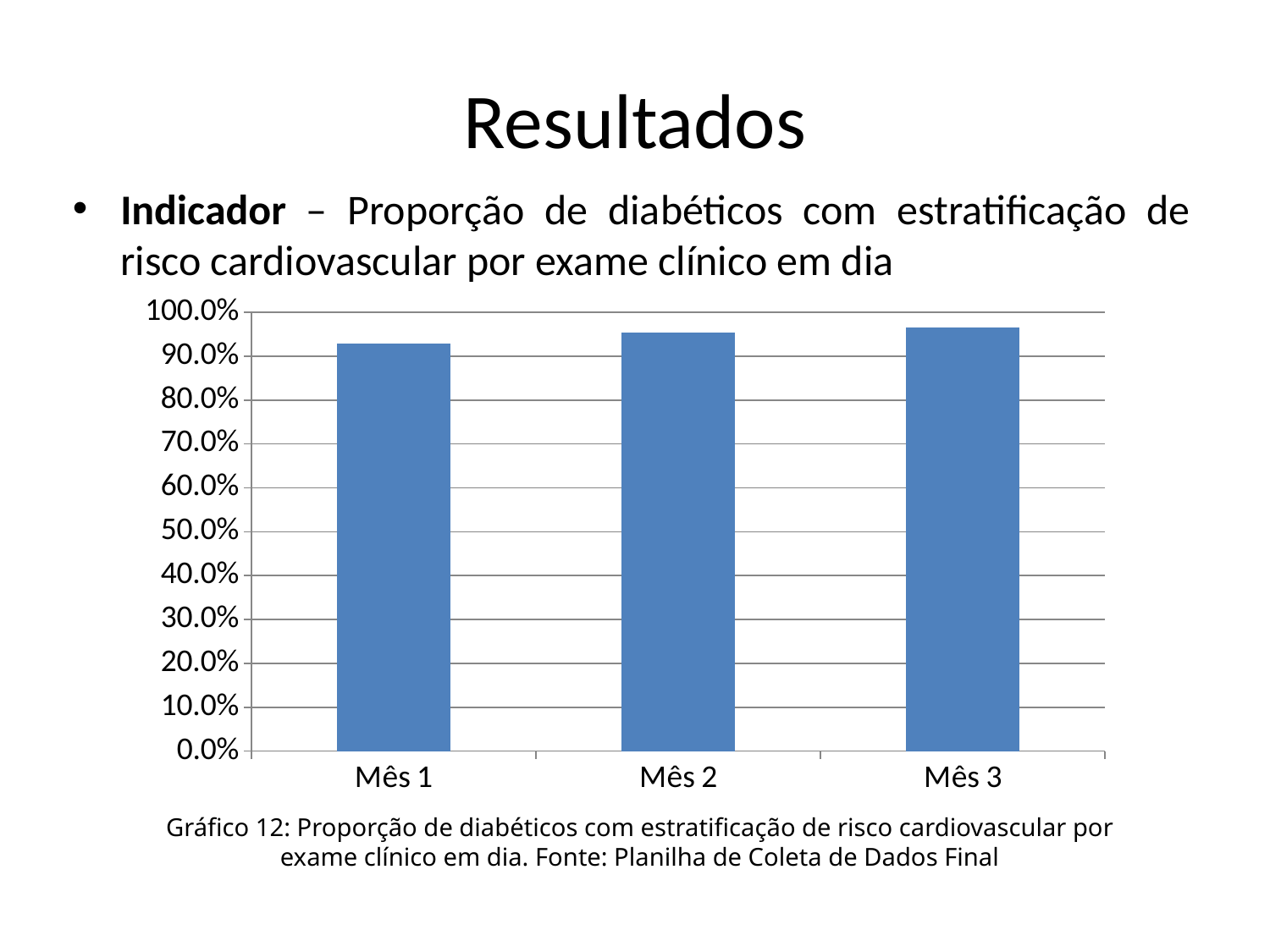
Which is larger, the value for Mês 1 or the value for Mês 3? Mês 3 Is the value for Mês 1 greater or less than 90.0%? greater How many categories (months) are shown on the x axis of the chart? 3 What is the number of the chart given in the caption below it? Gráfico 12 Is the value for Mês 2 greater or less than 100.0%? less Do the values rise or fall from Mês 1 to Mês 3? rise Is the value for Mês 1 greater or less than 80.0%? greater What kind of chart is shown on the slide? bar chart What is the highest value shown on the y axis of the chart? 100.0% Which month has the lowest value in the chart? Mês 1 Which is larger, the value for Mês 1 or the value for Mês 2? Mês 2